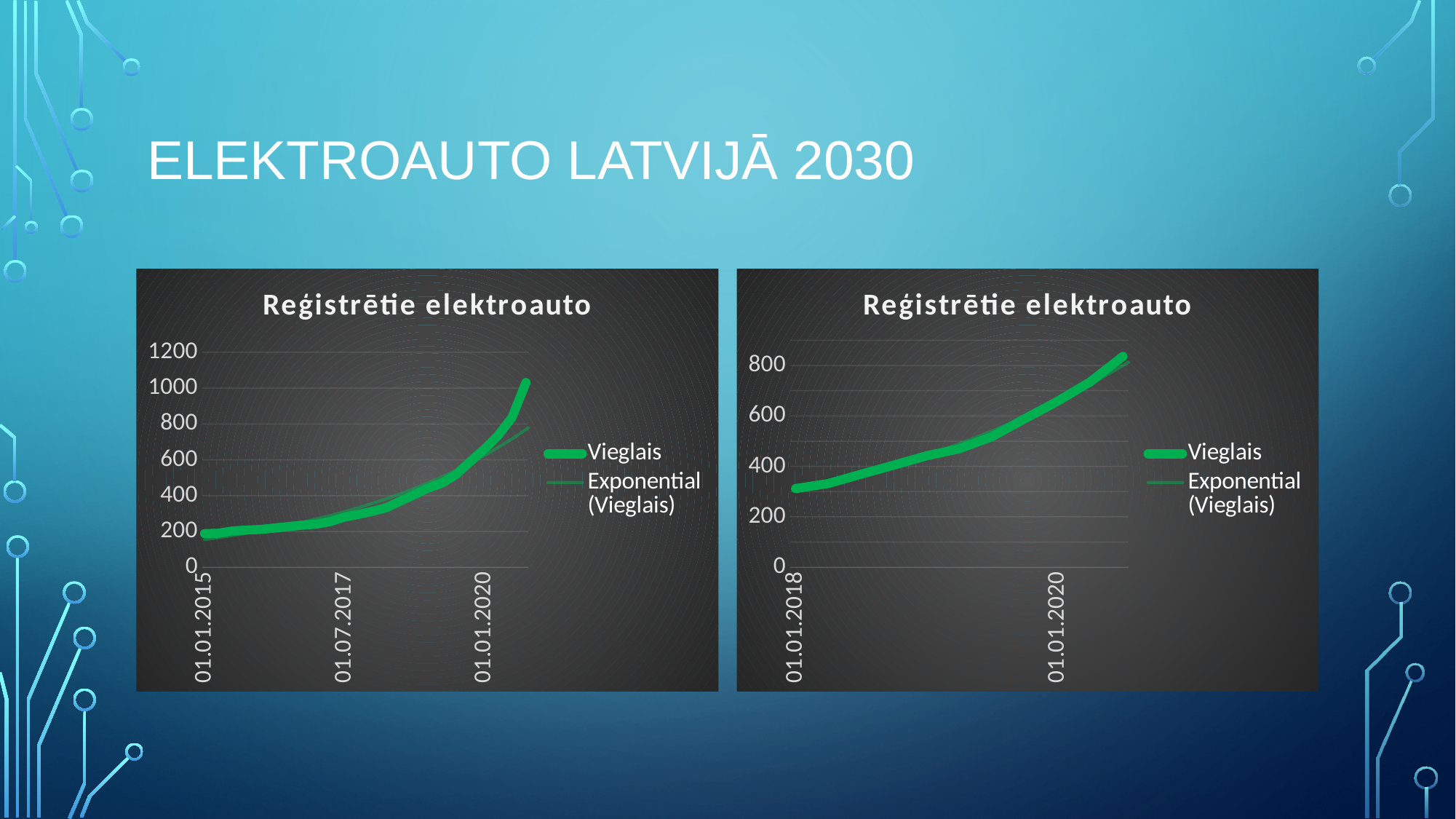
What is the highest value shown on the y axis of the left chart? 1200 In the left chart, does the Vieglais line rise or fall from 01.01.2015 to the end of the series? rises In the left chart, is the Vieglais value at 01.07.2017 greater or less than 400? less In the right chart, does the Vieglais line rise or fall from 01.01.2018 onward? rises How many series does the legend of the right chart list? 2 What type of chart is the left chart titled 'Reģistrētie elektroauto'? line chart In the right chart, is the final Vieglais value greater or less than 600? greater In the right chart, is the Vieglais value at 01.01.2018 greater or less than 400? less What are the two legend entries in the left chart? Vieglais; Exponential (Vieglais) What is the first date label on the x axis of the right chart? 01.01.2018